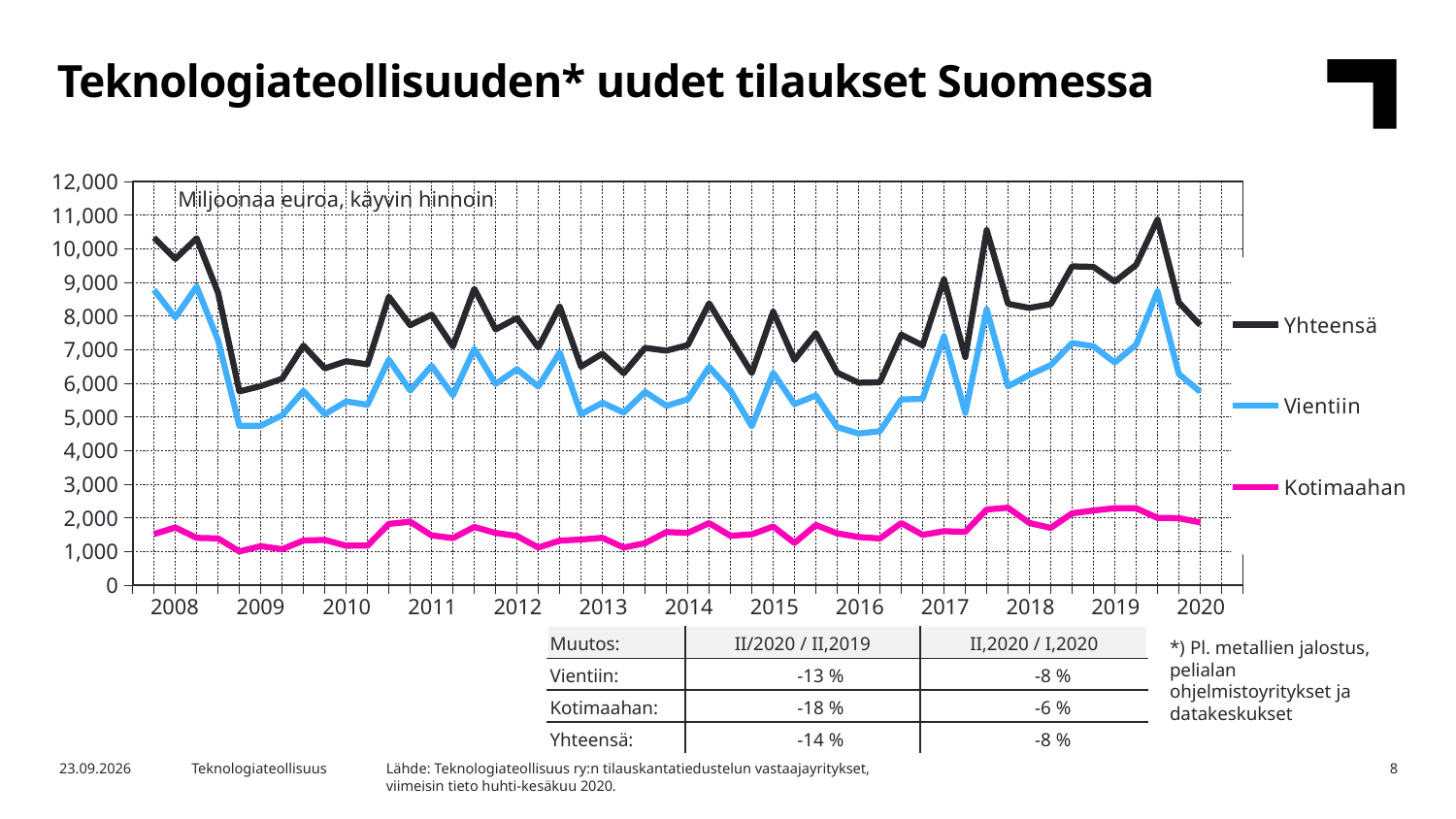
Does the Yhteensä line rise or fall from its 2019 peak to 2020? fall Which series has the lowest values throughout the chart? Kotimaahan Which series does the legend list in pink? Kotimaahan Is the lowest value for Vientiin in 2016 greater or less than 5,000? less In 2020, which is larger, the value for Vientiin or the value for Kotimaahan? Vientiin What kind of chart is shown on the slide? line chart Is the value for Kotimaahan in 2020 greater or less than 3,000? less Is the peak value for Yhteensä in 2019 greater or less than 10,000? greater How many series does the legend list? 3 How many year labels are shown on the x axis? 13 Which series has the highest values throughout the chart? Yhteensä What unit is stated in the note inside the chart area? Miljoonaa euroa, käyvin hinnoin